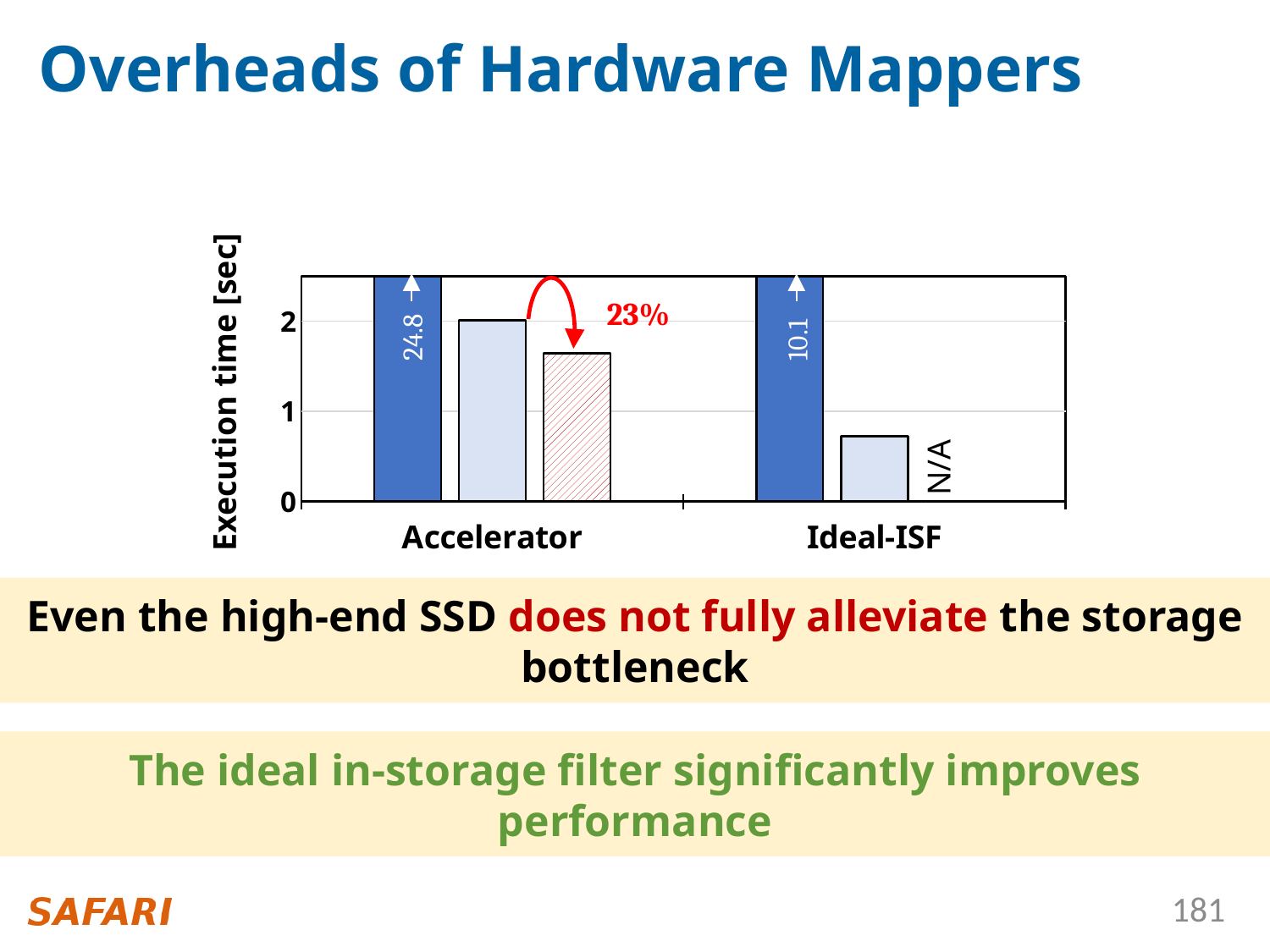
Which category has the larger labeled dark blue bar value, Accelerator or Ideal-ISF? Accelerator What kind of chart is shown on the slide? bar chart Is the value of the red hatched bar for Accelerator greater or less than 2? less How many categories are shown on the x axis of the chart? 2 Is the value of the light blue bar for Ideal-ISF greater or less than 1? less Is the value of the light blue bar for Accelerator greater or less than 1? greater What value is printed on the tall dark blue bar for Ideal-ISF? 10.1 What value is printed on the tall dark blue bar for Accelerator? 24.8 What percentage is annotated in red next to the arrow in the Accelerator group? 23% What is the difference between the labeled dark blue bar values for Accelerator (24.8) and Ideal-ISF (10.1)? 14.7 What is the title of the y axis of the chart? Execution time [sec]